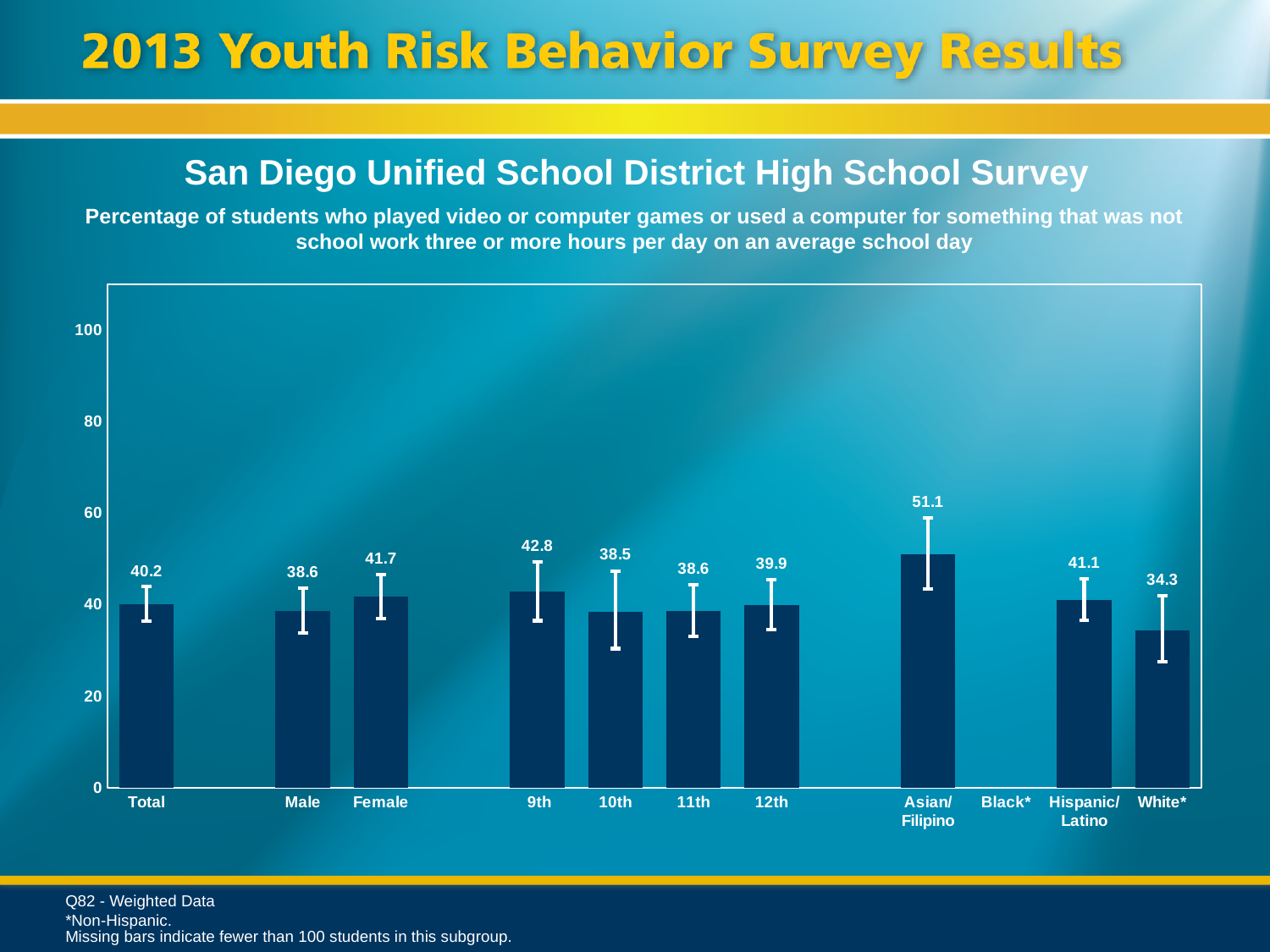
What is the value for 10th? 38.5 Which category with a plotted bar has the lowest value? White* Which is larger, the value for 9th or the value for 12th? 9th Is the value for Hispanic/Latino greater or less than 60? less Which category has no bar plotted? Black* What is the value for Asian/Filipino? 51.1 Which category has the highest value? Asian/Filipino What is the value for White*? 34.3 What kind of chart is shown? bar chart What is the difference between the Female and Male values? 3.1 How many categories are labelled on the x axis? 11 What is the value for Total? 40.2